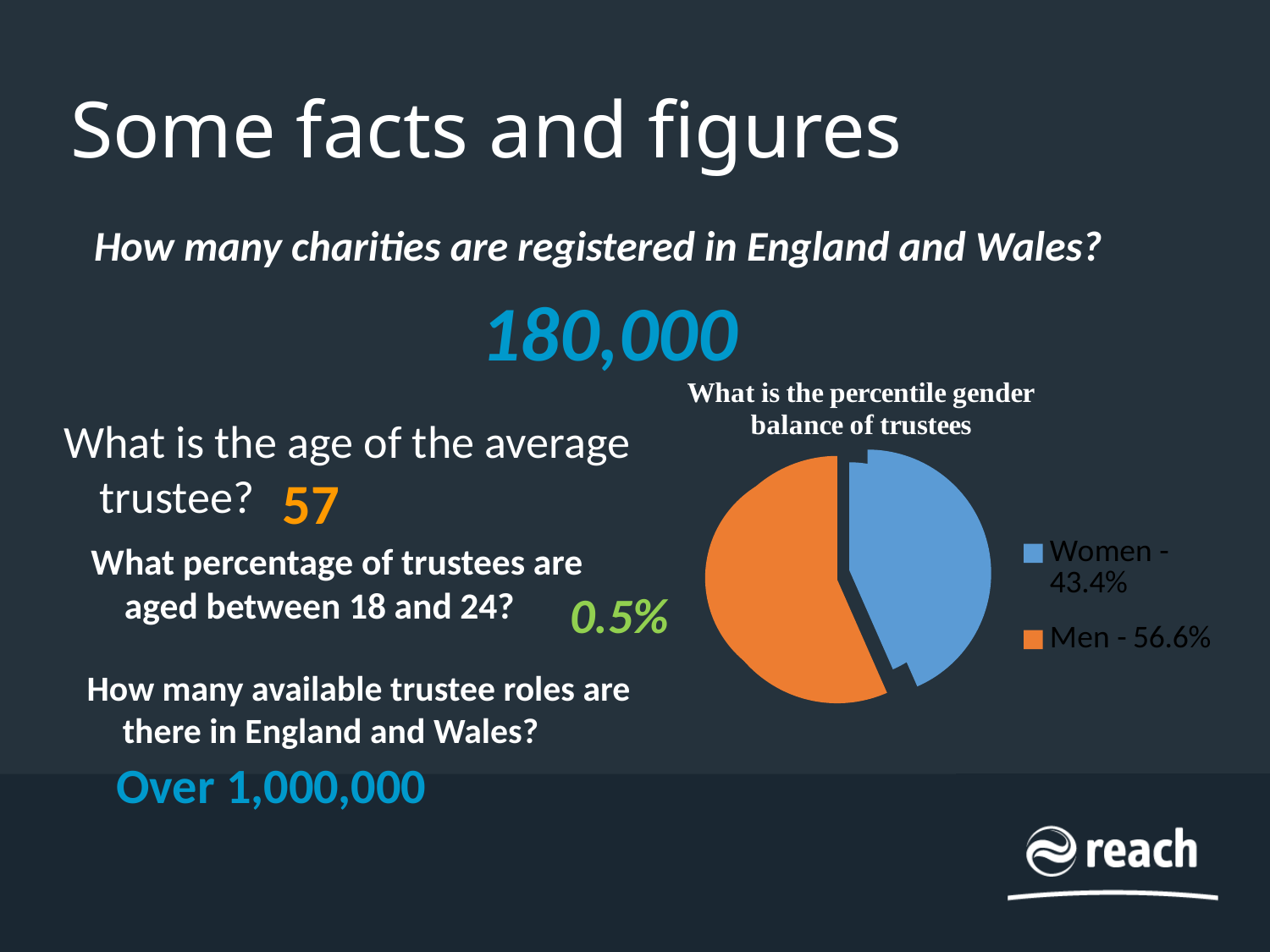
What kind of chart is shown on the slide? pie chart Which slice of the pie chart is the largest? Men Which is larger in the pie chart, the share for Women or the share for Men? Men Which slice of the pie chart is the smallest? Women How many slices does the pie chart have? 2 What percentage of trustees are women according to the pie chart? 43.4% What percentage of trustees are men according to the pie chart? 56.6% Is the share for Men in the pie chart greater or less than 50%? greater What is the title of the pie chart? What is the percentile gender balance of trustees What colour is the Women slice in the pie chart? blue What is the difference between the Men and Women percentages in the pie chart? 13.2%